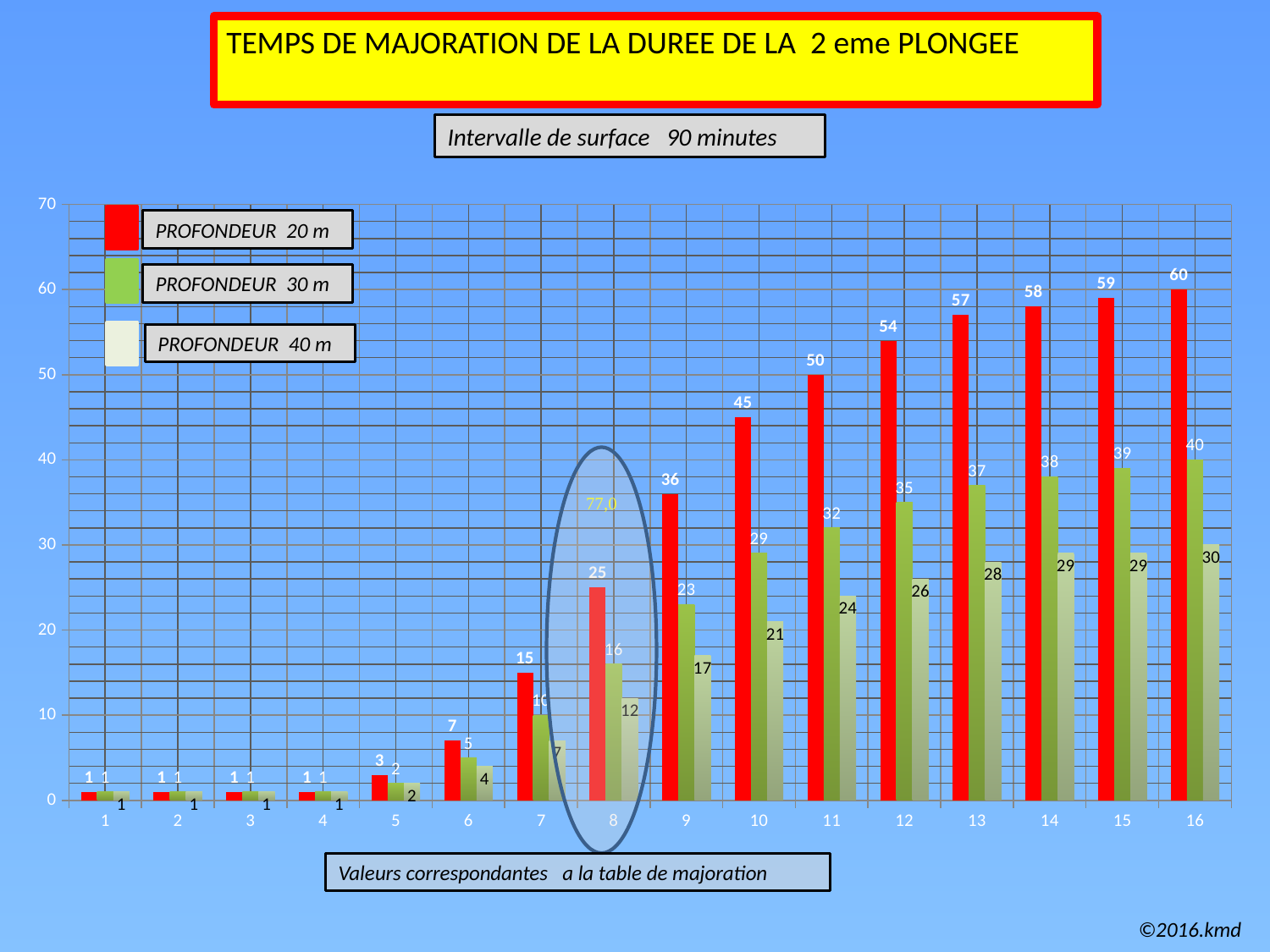
How many categories are shown on the x axis? 16 What is the value for PROFONDEUR 40 m at category 12? 26 What surface interval is stated on the slide? 90 minutes What is the difference between the PROFONDEUR 20 m and PROFONDEUR 30 m values at category 16? 20 What is the difference between the PROFONDEUR 20 m and PROFONDEUR 40 m values at category 8? 13 What is the value for PROFONDEUR 30 m at category 10? 29 Do the PROFONDEUR 20 m values rise or fall from category 1 to category 16? Rise Which category has the highest value for PROFONDEUR 20 m? 16 At category 9, which series has the larger value, PROFONDEUR 20 m or PROFONDEUR 40 m? PROFONDEUR 20 m How many series does the legend list? 3 What is the value for PROFONDEUR 20 m at category 16? 60 What kind of chart is shown on the slide? Bar chart